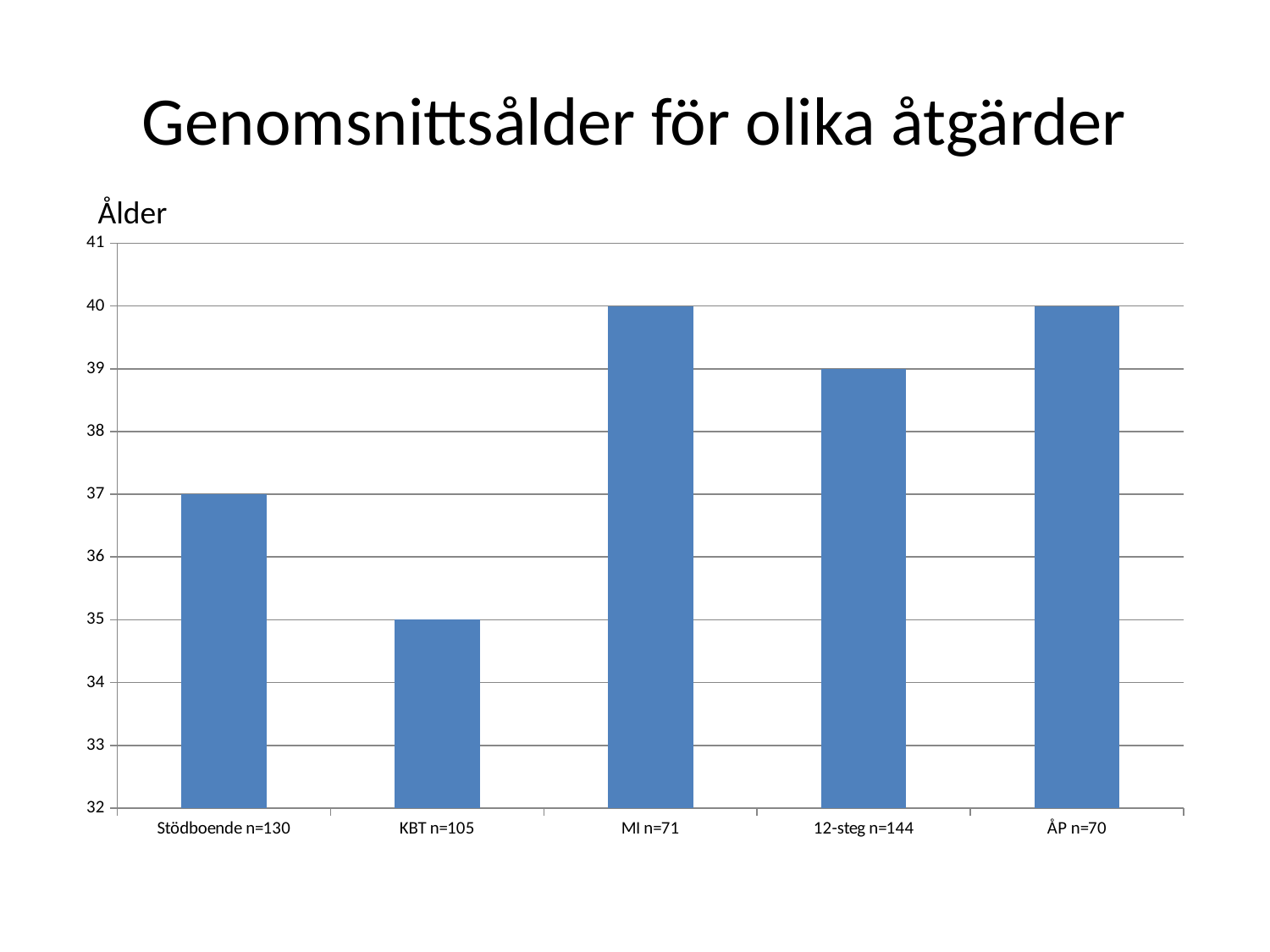
What is the value for MI n=71? 40 What is the value for 12-steg n=144? 39 What is the difference between the values for MI n=71 and KBT n=105? 5 What kind of chart is shown on the slide? bar chart Which category has the lowest value? KBT n=105 Which is larger, the value for Stödboende n=130 or the value for KBT n=105? Stödboende n=130 What is the value for Stödboende n=130? 37 What is the difference between the values for 12-steg n=144 and Stödboende n=130? 2 How many categories are shown on the x axis? 5 Is the value for ÅP n=70 greater or less than 38? greater What is the value for KBT n=105? 35 What is the title of the slide? Genomsnittsålder för olika åtgärder